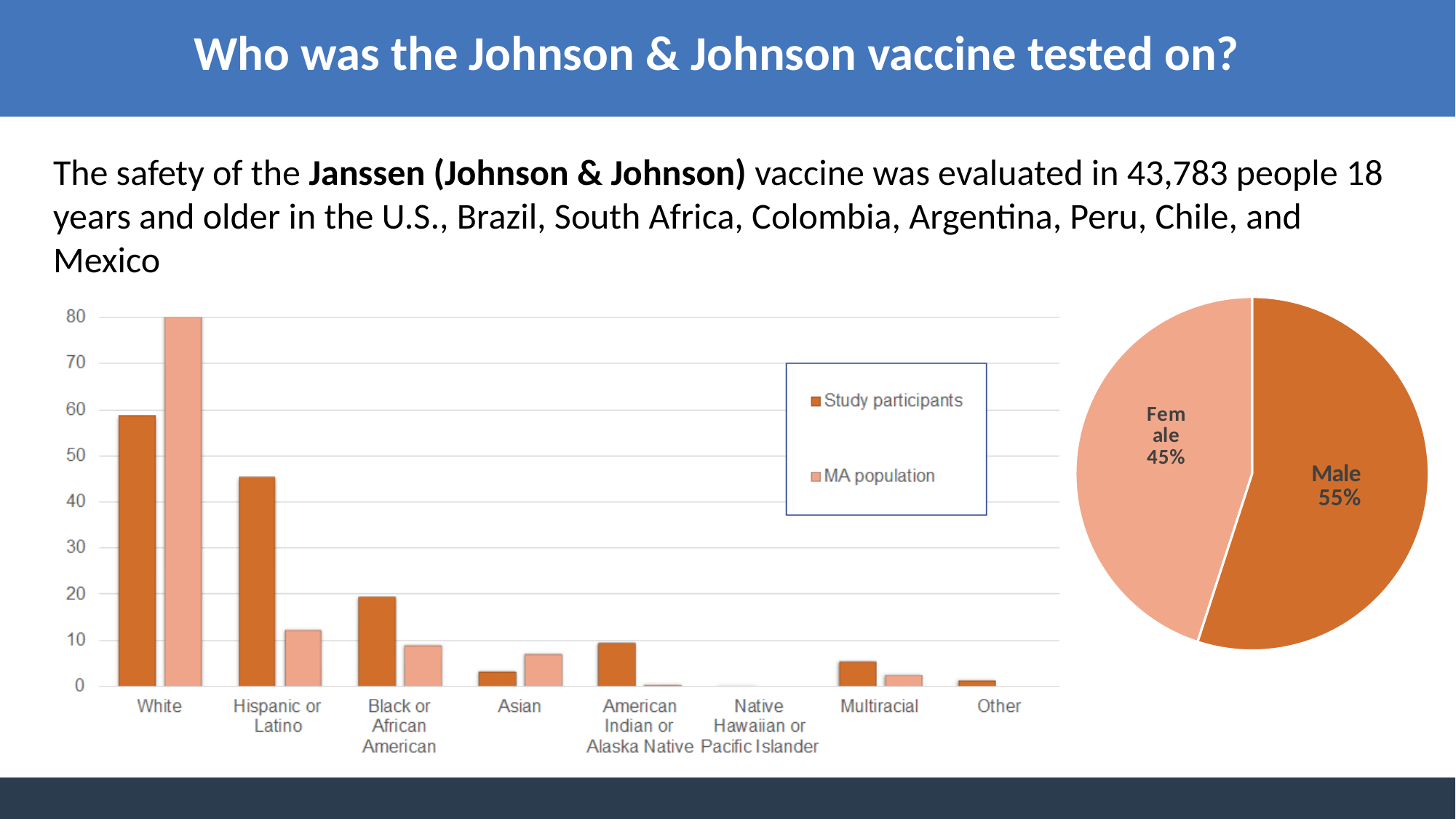
In the bar chart on the left, which is larger for Asian: Study participants or MA population? MA population In the pie chart on the right, what share of participants were Male? 55% In the bar chart on the left, which is larger for Hispanic or Latino: Study participants or MA population? Study participants In the bar chart on the left, how many series does the legend list? 2 In the bar chart on the left, is the Study participants value for White greater or less than 50? greater In the bar chart on the left, which category has the highest Study participants value? White In the bar chart on the left, what kind of chart is it? bar chart In the bar chart on the left, is the Study participants value for Hispanic or Latino greater or less than 40? greater In the pie chart on the right, what share of participants were Female? 45% In the bar chart on the left, how many race/ethnicity categories are shown on the x axis? 8 In the bar chart on the left, which category has the highest MA population value? White In the bar chart on the left, is the MA population value for Black or African American greater or less than 10? less